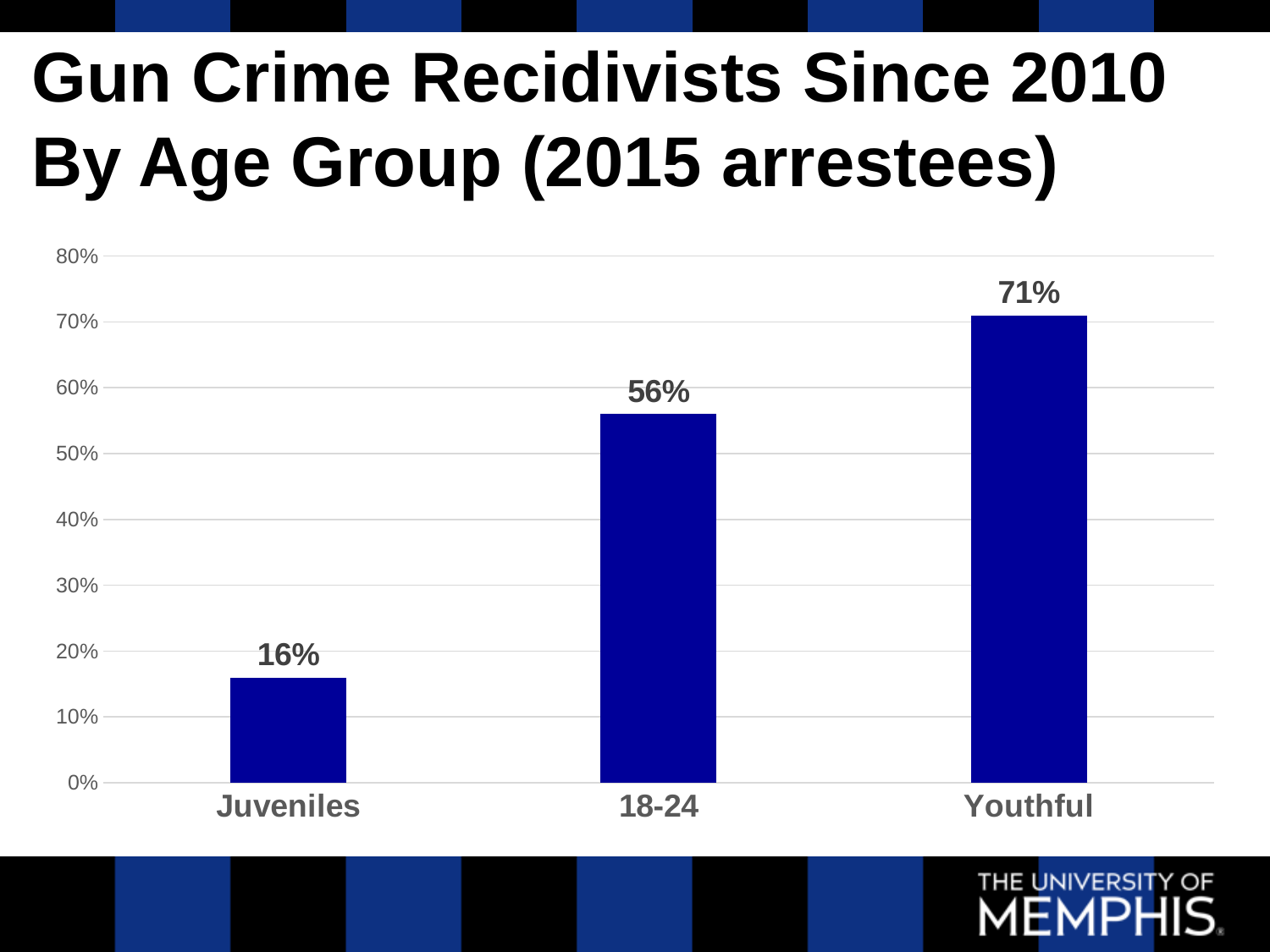
Which is larger, the value for Juveniles or the value for 18-24? 18-24 Is the value for Youthful greater or less than 60%? greater What is the difference between the values for Youthful and 18-24? 15% Which age group has the highest value? Youthful What is the difference between the values for 18-24 and Juveniles? 40% What kind of chart is shown on the slide? bar chart What is the value for the 18-24 age group? 56% How many age groups are shown in the chart? 3 What is the value for Juveniles? 16% Which age group has the lowest value? Juveniles Do the values rise or fall from left to right across the age groups? rise What is the value for Youthful? 71%